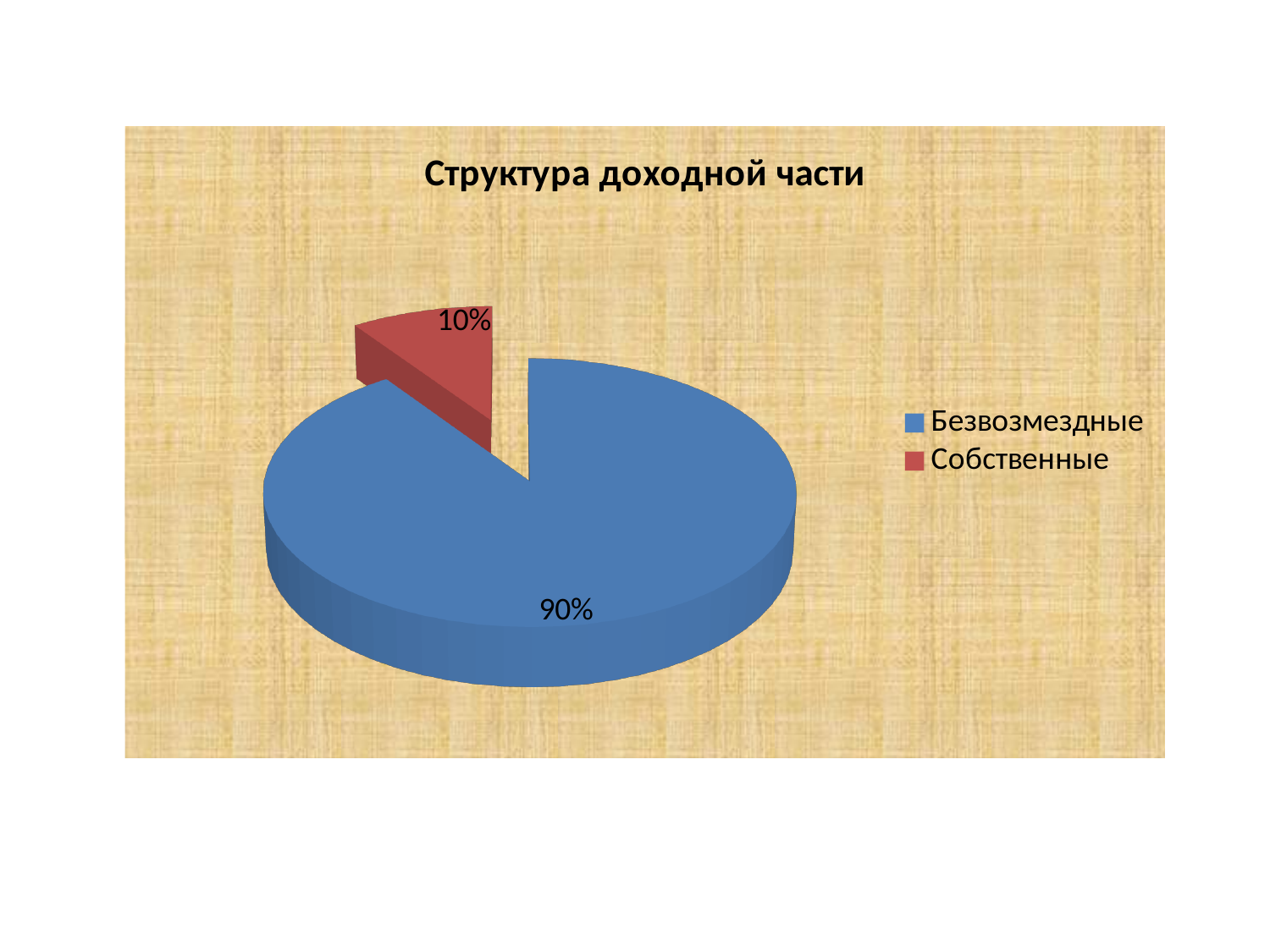
What kind of chart is shown on the slide? Pie chart Which category has the largest slice of the pie? Безвозмездные What share of the pie does Безвозмездные take? 90% How many slices does the pie chart have? 2 What colour is the slice for Собственные? Red What share of the pie does Собственные take? 10% What is the difference in percentage points between Безвозмездные and Собственные? 80 percentage points Which is larger, Безвозмездные or Собственные? Безвозмездные Which category has the smallest slice of the pie? Собственные How many entries does the legend list? 2 What is the title of the chart? Структура доходной части